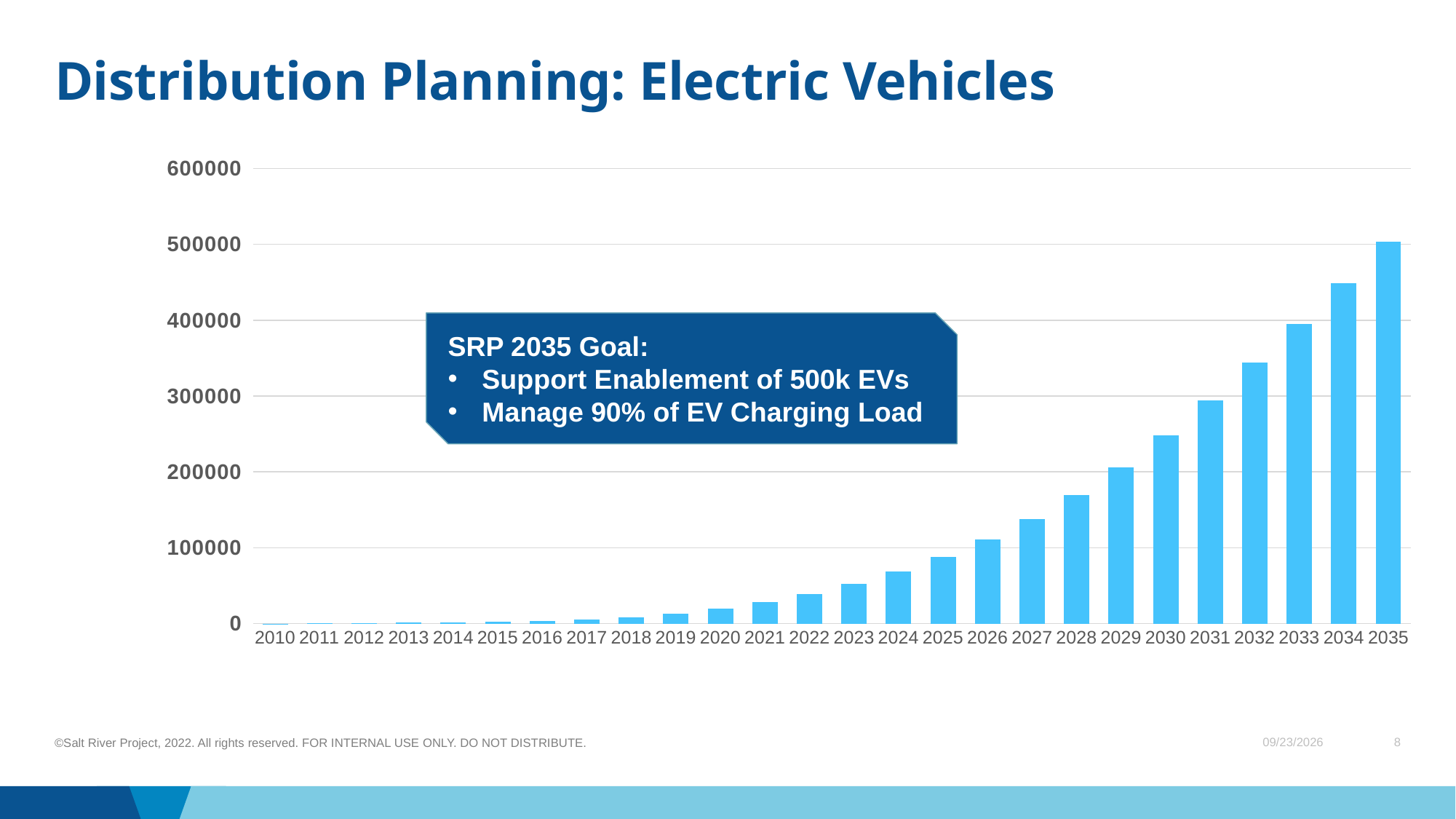
Which year has the highest bar on the chart? 2035 Which year has the lowest bar on the chart? 2010 Which year has the larger value, 2030 or 2025? 2030 Do the values rise or fall from 2010 to 2035? rise Is the value for 2020 greater or less than 100000? less Is the value for 2028 greater or less than 200000? less Is the value for 2034 greater or less than 500000? less How many years (bars) are plotted on the chart? 26 What kind of chart is shown on the slide? bar chart What is the highest value shown on the vertical axis? 600000